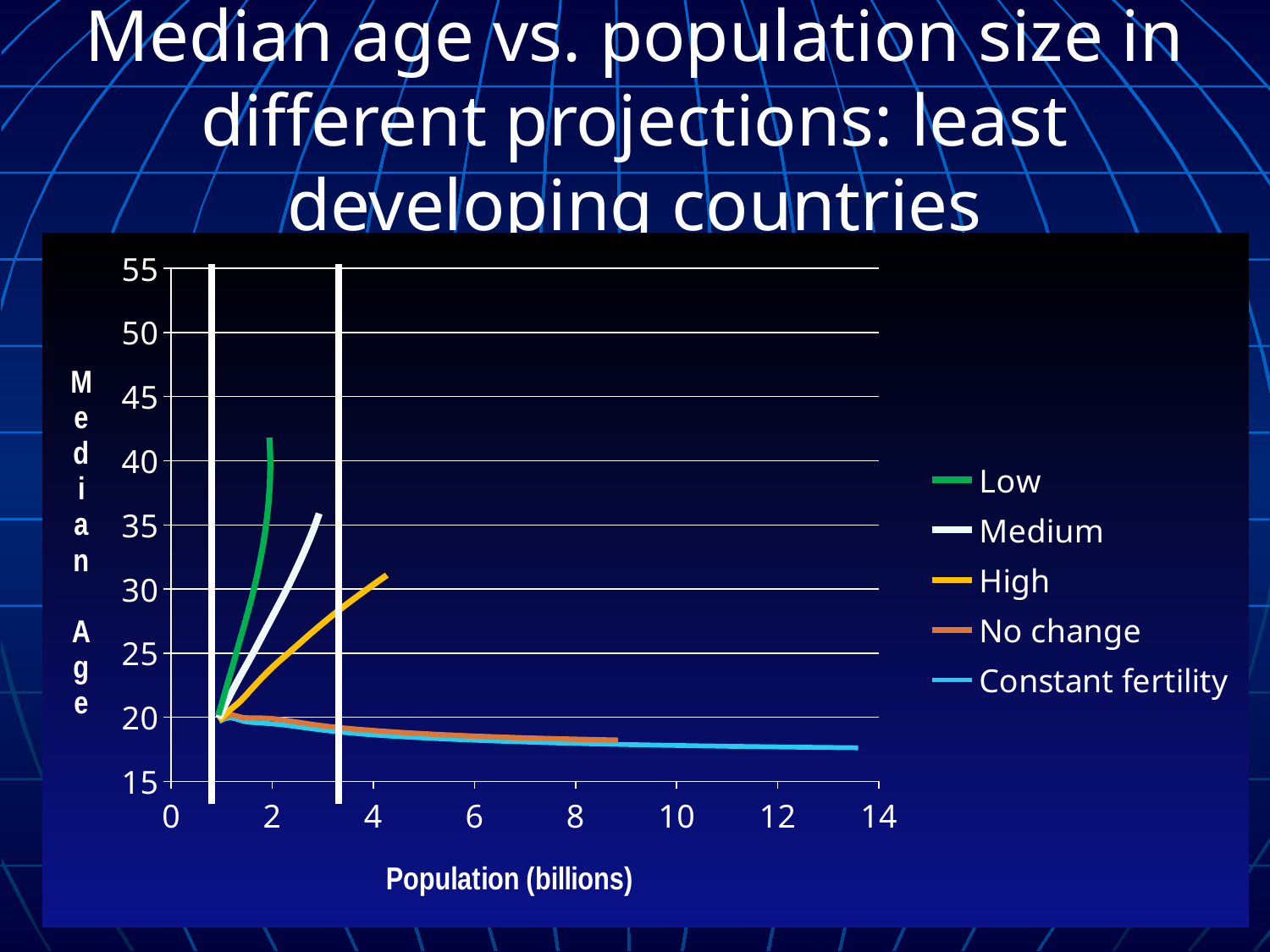
Is the median age at the end of the Constant fertility series greater or less than 20? less Which series reaches a higher median age, Medium or High? Medium Which series reaches the highest median age? Low What kind of chart is shown on the slide? line chart Is the highest median age reached by the Low series greater or less than 35? greater What is the label of the x axis? Population (billions) How many series does the legend list? 5 Which series are listed in the legend? Low, Medium, High, No change, Constant fertility Does the median age in the Low series rise or fall as population increases? rise Is the largest population reached by the No change series greater or less than 6 billion? greater Which series extends to the largest population? Constant fertility Does the median age in the Constant fertility series rise or fall as population increases? fall